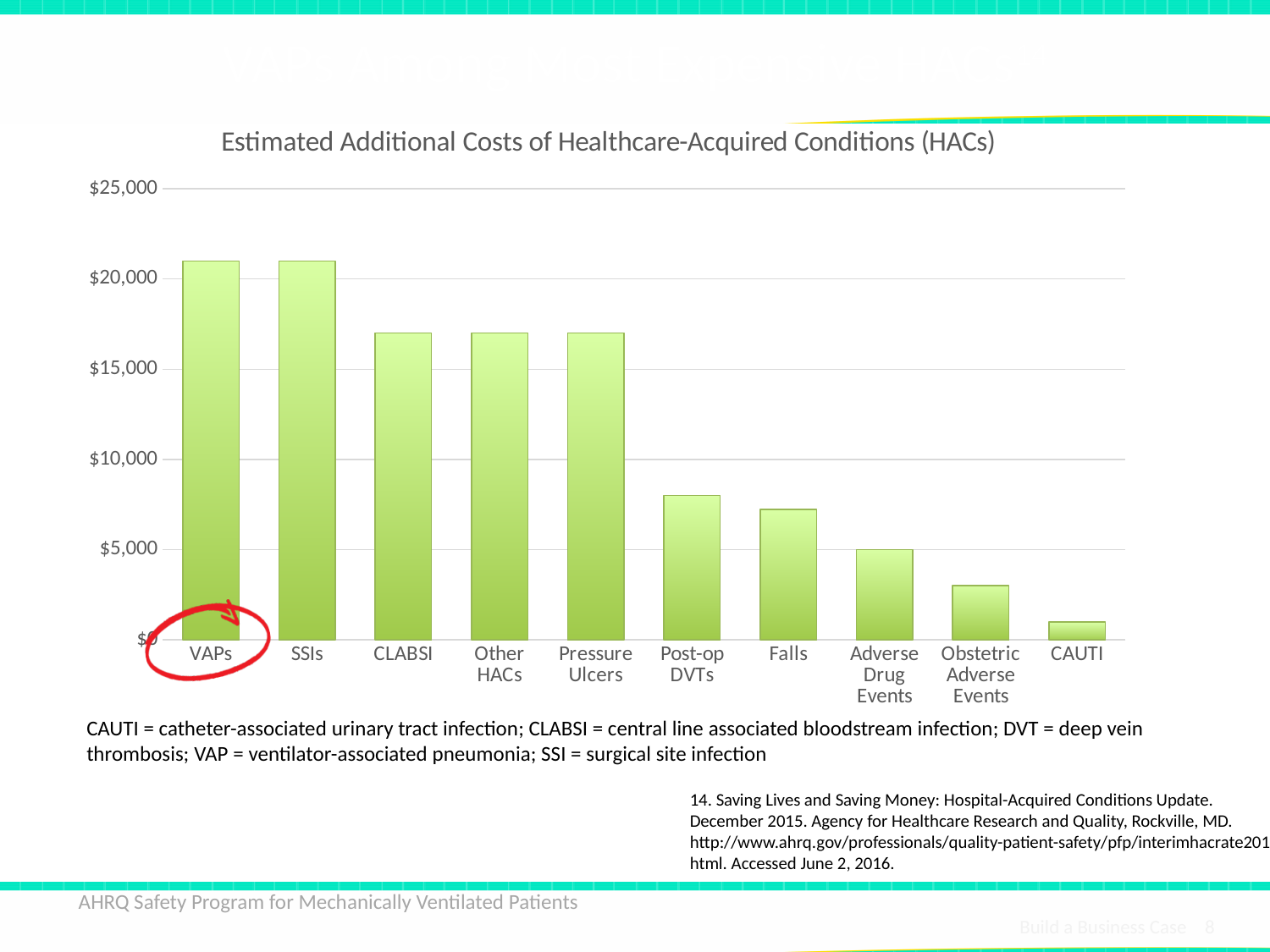
Is the value for CAUTI greater or less than $5,000? less Is the value for Obstetric Adverse Events greater or less than $5,000? less Which has a higher estimated additional cost, CAUTI or Pressure Ulcers? Pressure Ulcers How many healthcare-acquired conditions are plotted on the chart? 10 What kind of chart is shown on the slide? bar chart Which has a higher estimated additional cost, Falls or Adverse Drug Events? Falls Do the values generally rise or fall moving from left to right across the categories? fall Is the value for VAPs greater or less than $20,000? greater Which condition has the lowest estimated additional cost? CAUTI What is the title of the chart? Estimated Additional Costs of Healthcare-Acquired Conditions (HACs)